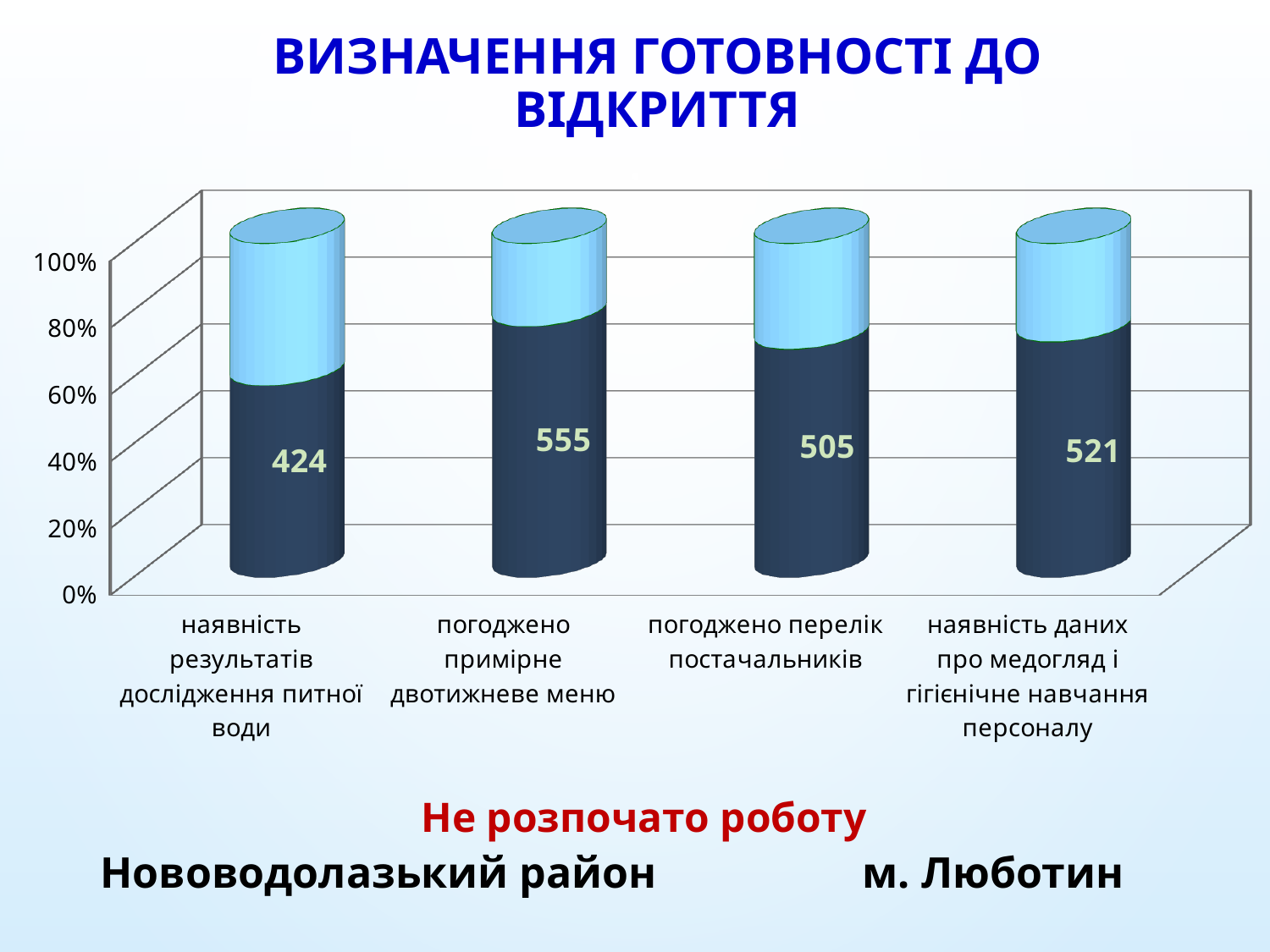
What is the title of the slide above the chart? ВИЗНАЧЕННЯ ГОТОВНОСТІ ДО ВІДКРИТТЯ Which has a larger labelled value: "погоджено перелік постачальників" or "наявність даних про медогляд і гігієнічне навчання персоналу"? наявність даних про медогляд і гігієнічне навчання персоналу Which category has the lowest labelled value? наявність результатів дослідження питної води What value is labelled on the dark blue segment for "погоджено примірне двотижневе меню"? 555 What kind of chart is shown on the slide? Stacked bar chart Which category has the highest labelled value? погоджено примірне двотижневе меню How many categories are shown on the x axis of the chart? 4 What is the difference between the labelled values for "наявність даних про медогляд і гігієнічне навчання персоналу" and "погоджено перелік постачальників"? 16 What value is labelled on the dark blue segment for "наявність даних про медогляд і гігієнічне навчання персоналу"? 521 What value is labelled on the dark blue segment for "погоджено перелік постачальників"? 505 What value is labelled on the dark blue segment for "наявність результатів дослідження питної води"? 424 What is the difference between the labelled values for "погоджено примірне двотижневе меню" and "наявність результатів дослідження питної води"? 131